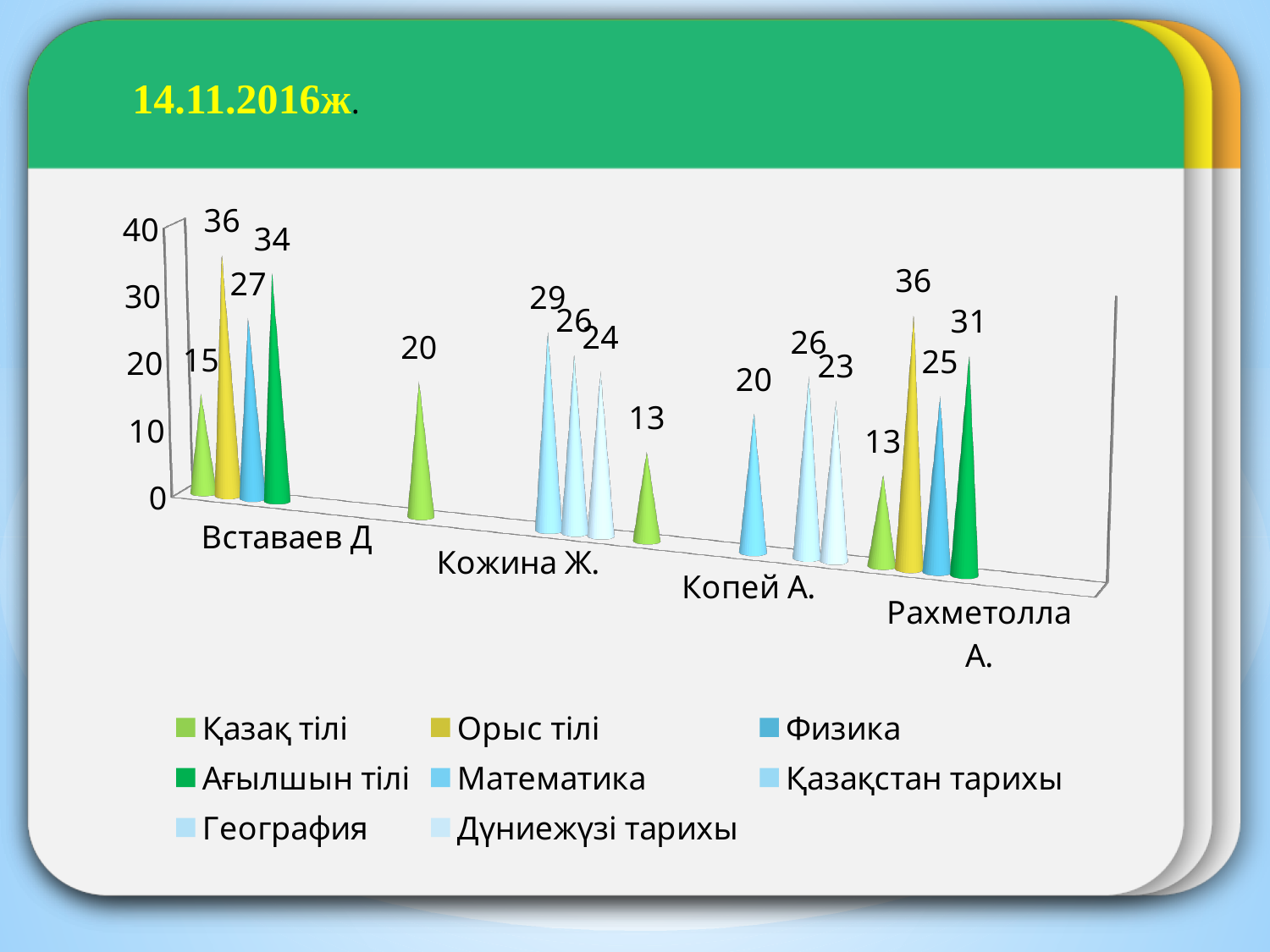
What is the title of the slide with the chart? 14.11.2016ж. What kind of chart is shown on the slide? bar chart What is the value of Қазақ тілі for Кожина Ж.? 20 Which student has the larger Қазақ тілі value, Вставаев Д or Кожина Ж.? Кожина Ж. How many students (categories) are shown on the x axis of the chart? 4 How many series does the chart's legend list? 8 What is the value of Қазақ тілі for Вставаев Д? 15 Which subject has the highest value for Вставаев Д? Орыс тілі What is the value of Орыс тілі for Вставаев Д? 36 Which subject has the lowest value for Рахметолла А.? Қазақ тілі What is the value of Ағылшын тілі for Рахметолла А.? 31 What is the difference between Орыс тілі and Қазақ тілі for Вставаев Д? 21